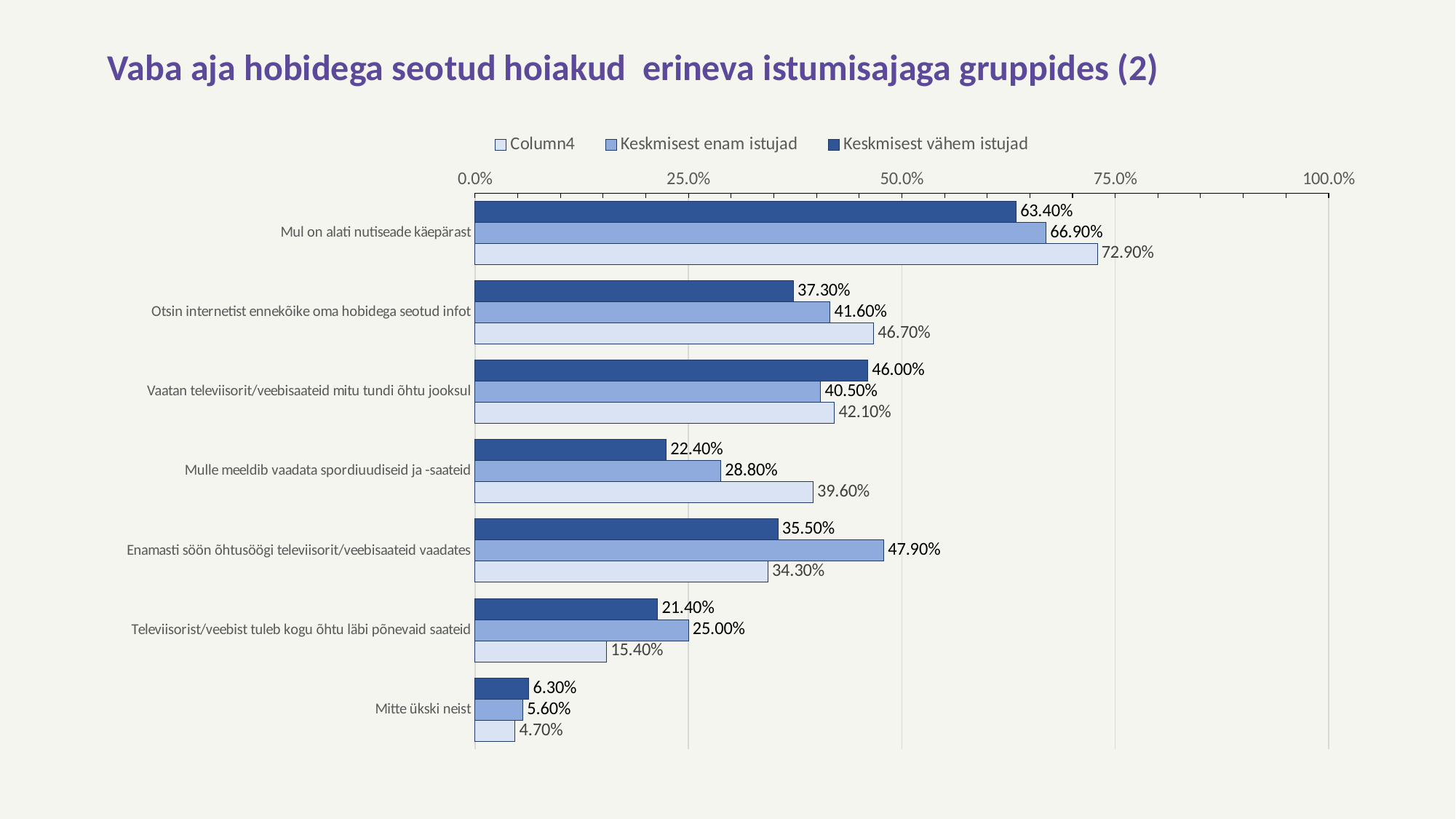
What is the value for 'Column4' in the category 'Mulle meeldib vaadata spordiuudiseid ja -saateid'? 39.60% What is the difference between the 'Column4' and 'Keskmisest vähem istujad' values for 'Mul on alati nutiseade käepärast'? 9.50% What is the value for 'Keskmisest vähem istujad' in the category 'Mul on alati nutiseade käepärast'? 63.40% Is the 'Keskmisest enam istujad' value for 'Otsin internetist ennekõike oma hobidega seotud infot' greater or less than 50.0%? less How many series does the legend list? 3 What is the value for 'Keskmisest enam istujad' in the category 'Enamasti söön õhtusöögi televiisorit/veebisaateid vaadates'? 47.90% What kind of chart is shown on the slide? bar chart In the category 'Vaatan televiisorit/veebisaateid mitu tundi õhtu jooksul', which is larger: 'Keskmisest vähem istujad' or 'Keskmisest enam istujad'? Keskmisest vähem istujad Which category has the lowest value for 'Keskmisest vähem istujad'? Mitte ükski neist What is the title of the chart slide? Vaba aja hobidega seotud hoiakud erineva istumisajaga gruppides (2) How many categories are shown on the chart? 7 Which category has the highest value for 'Column4'? Mul on alati nutiseade käepärast